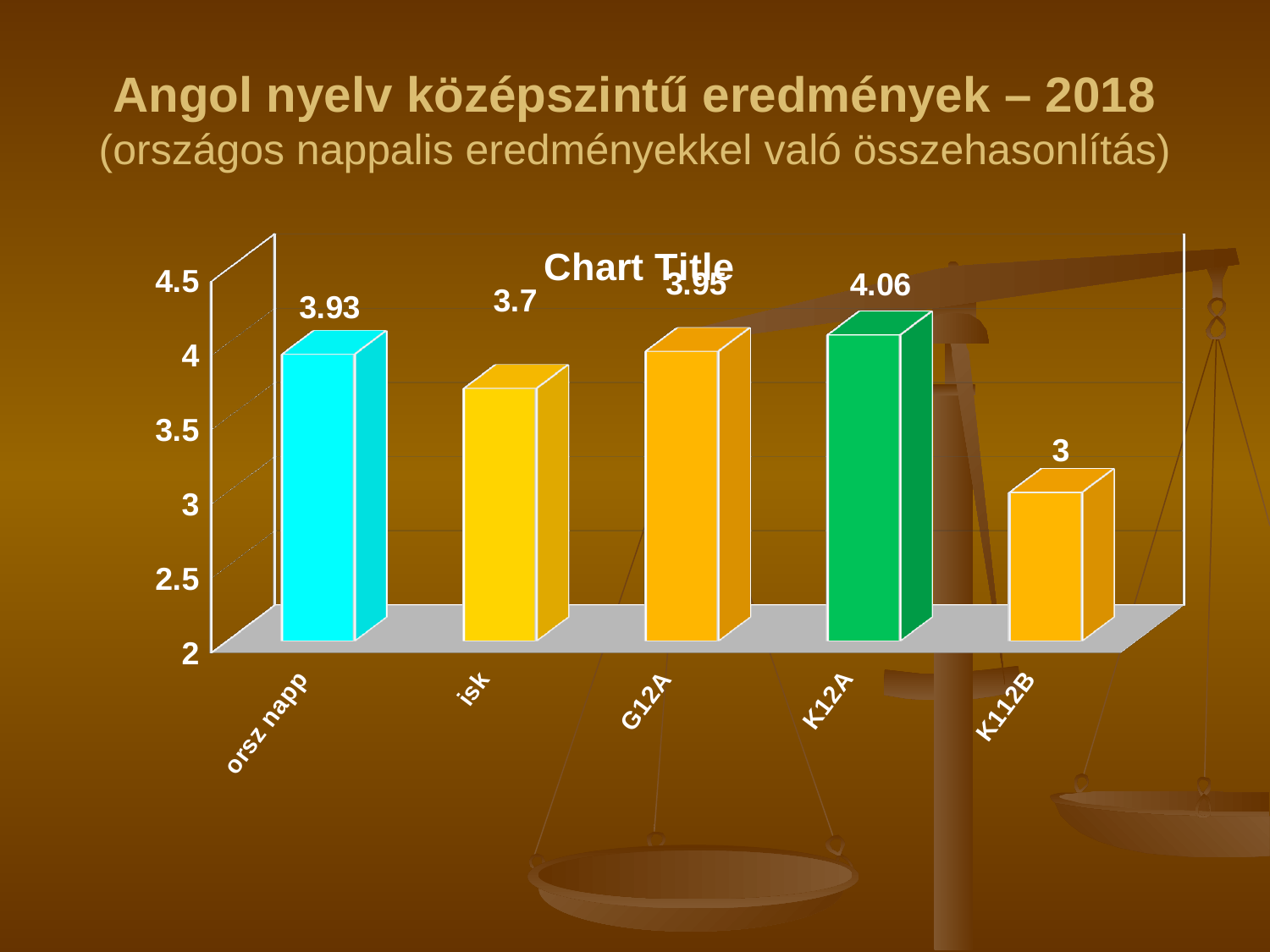
Which is larger, the value for isk or the value for G12A? G12A What is the difference between the values for orsz napp and isk? 0.23 What is the value for K12A? 4.06 Which category has the highest value? K12A What kind of chart is shown on the slide? bar chart What is the value for K112B? 3 Is the value for K112B greater or less than 3.5? less How many categories are shown on the x axis? 5 What is the difference between the values for K12A and K112B? 1.06 Which category has the lowest value? K112B What is the value for isk? 3.7 What is the value for orsz napp? 3.93